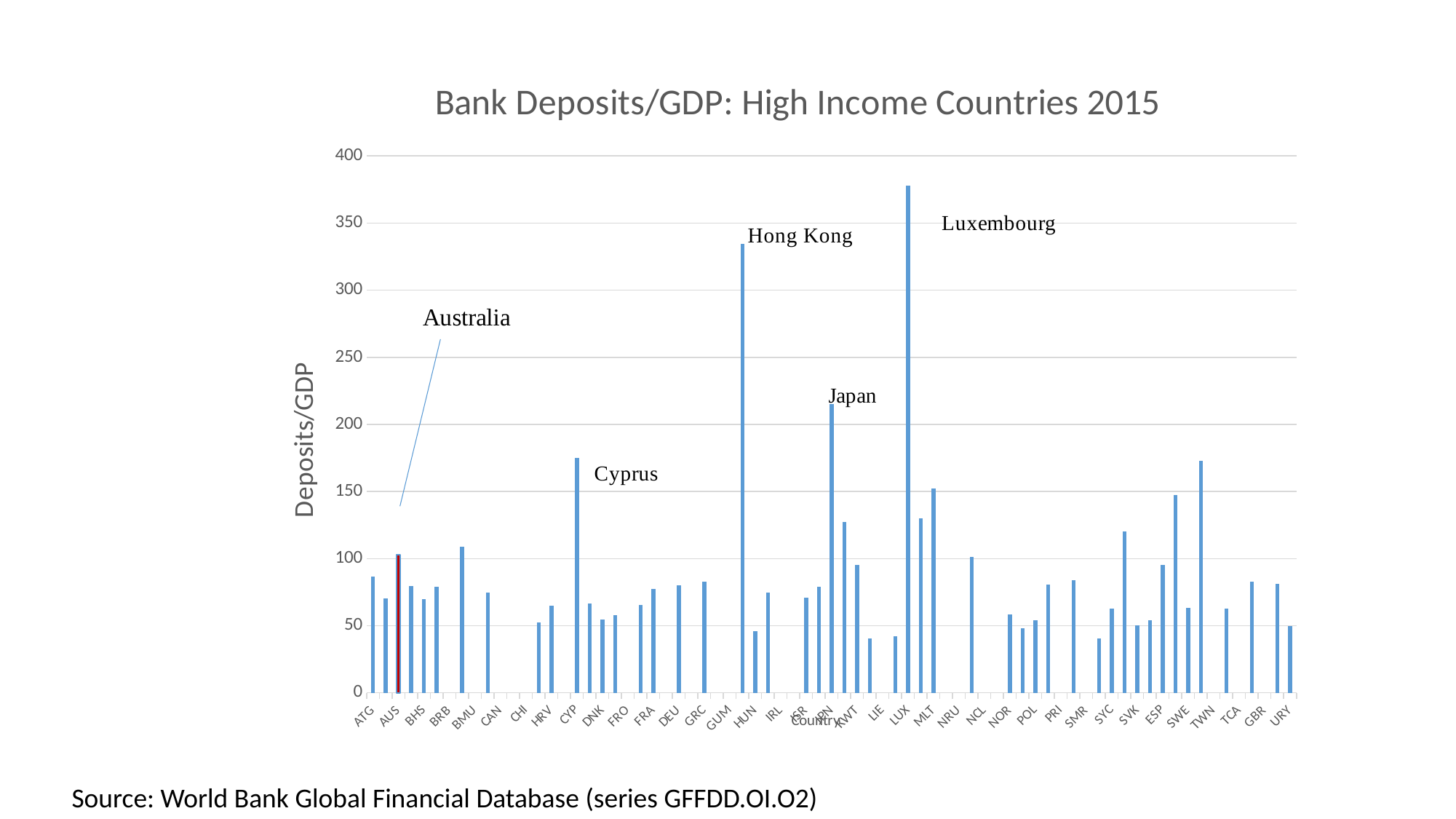
Is the value for Luxembourg greater or less than 350? greater Which has a higher Deposits/GDP value, Cyprus or Japan? Japan Which has a higher Deposits/GDP value, Hong Kong or Japan? Hong Kong Which has a higher Deposits/GDP value, Luxembourg or Hong Kong? Luxembourg What kind of chart is shown on the slide? bar chart Is the value for Cyprus greater or less than 150? greater Is the value for Hong Kong greater or less than 300? greater What is the title of the chart? Bank Deposits/GDP: High Income Countries 2015 What is the label on the vertical axis of the chart? Deposits/GDP Which country has the highest Deposits/GDP value in the chart? Luxembourg